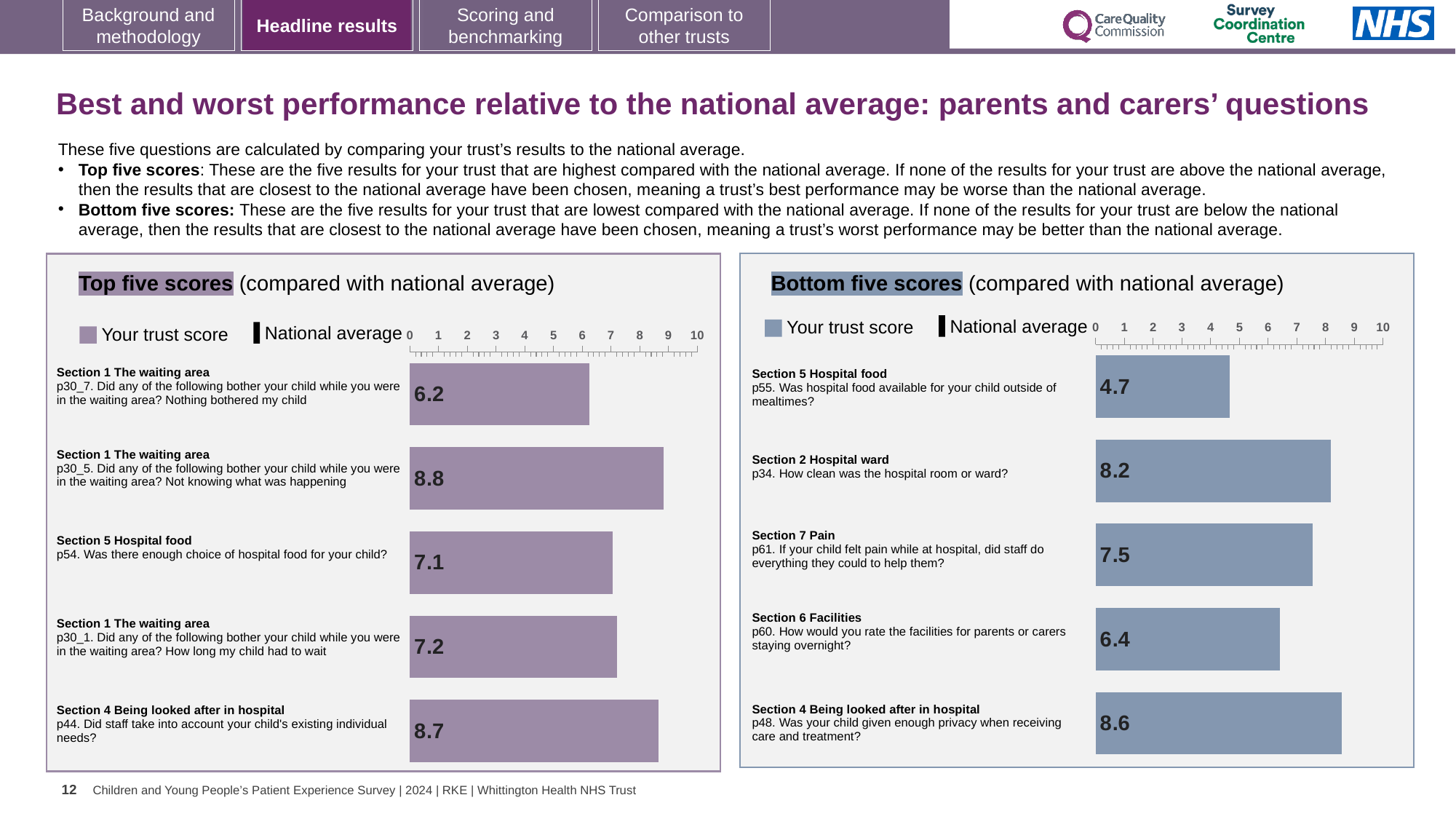
What type of chart is the Top five scores chart? Bar chart In the Top five scores chart, what is the trust score for p44 (Did staff take into account your child's existing individual needs)? 8.7 In the Top five scores chart, which has the higher trust score: p54 (enough choice of hospital food) or p30_1 (how long my child had to wait)? p30_1 (7.2) In the Top five scores chart, what is the trust score for p30_5 (Not knowing what was happening in the waiting area)? 8.8 In the Bottom five scores chart, what is the trust score for p34 (How clean was the hospital room or ward)? 8.2 In the Top five scores chart, what is the difference between the trust scores for p30_5 and p30_7? 2.6 In the Bottom five scores chart, which question has the highest trust score? p48. Was your child given enough privacy when receiving care and treatment? (8.6) In the Bottom five scores chart, which question has the lowest trust score? p55. Was hospital food available for your child outside of mealtimes? (4.7) How many questions are plotted in the Bottom five scores chart? 5 In the Top five scores chart, which question has the lowest trust score? p30_7. Nothing bothered my child (6.2) In the Bottom five scores chart, what is the trust score for p55 (Was hospital food available for your child outside of mealtimes)? 4.7 In the Bottom five scores chart, what is the difference between the trust scores for p48 and p55? 3.9